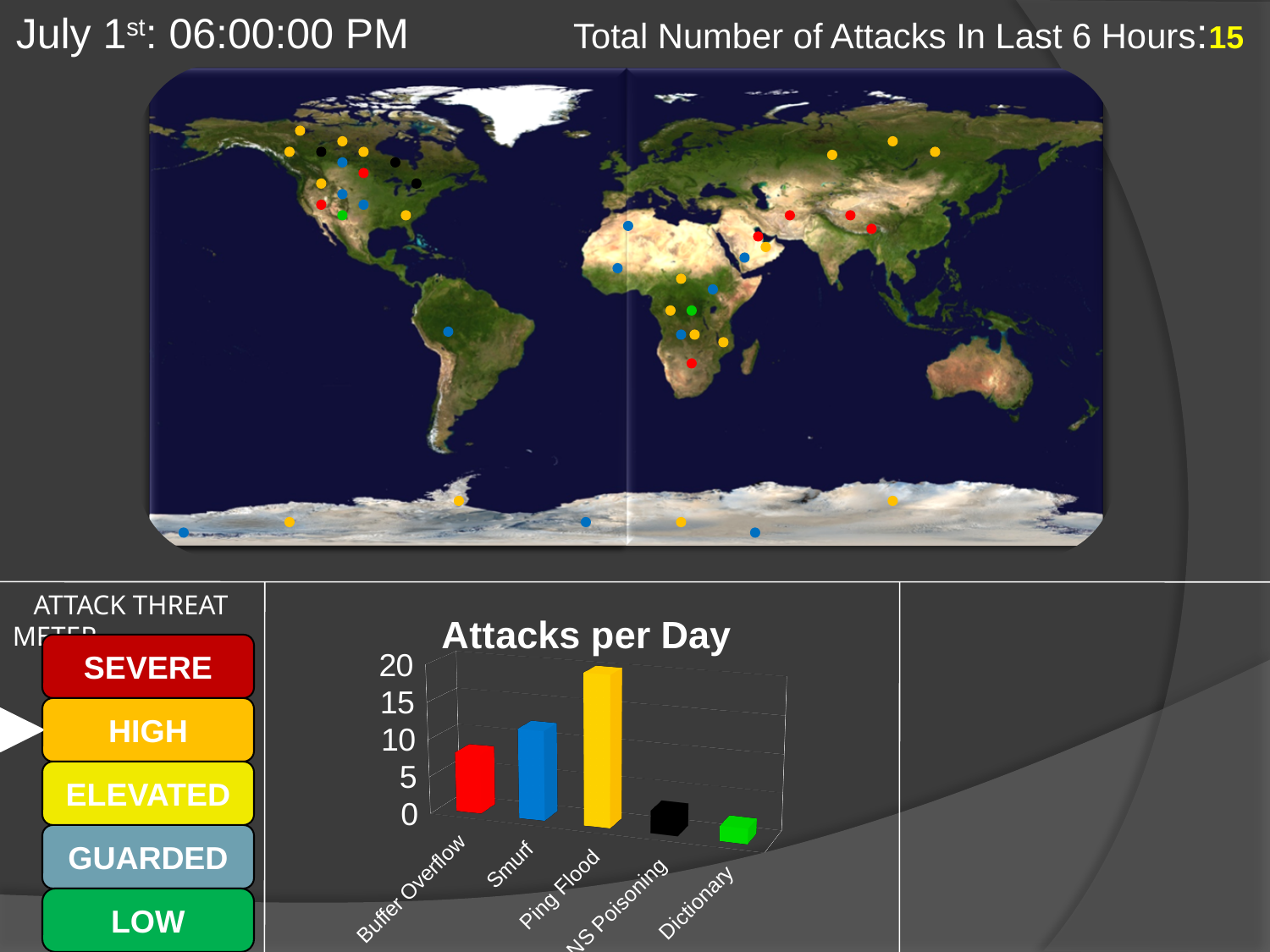
In the "Attacks per Day" chart, which is larger, Buffer Overflow or Dictionary? Buffer Overflow In the "Attacks per Day" chart, which is larger, Ping Flood or Smurf? Ping Flood Which attack category has the highest value in the "Attacks per Day" chart? Ping Flood How many attack categories are shown in the "Attacks per Day" chart? 5 What type of chart is the "Attacks per Day" chart? bar chart In the "Attacks per Day" chart, is the value for Ping Flood greater or less than 15? greater In the "Attacks per Day" chart, is the value for Smurf greater or less than 10? greater In the "Attacks per Day" chart, is the value for Buffer Overflow greater or less than 10? less What colour is the Ping Flood bar in the "Attacks per Day" chart? yellow In the "Attacks per Day" chart, which is larger, Smurf or Buffer Overflow? Smurf What is the title of the chart at the bottom of the slide? Attacks per Day